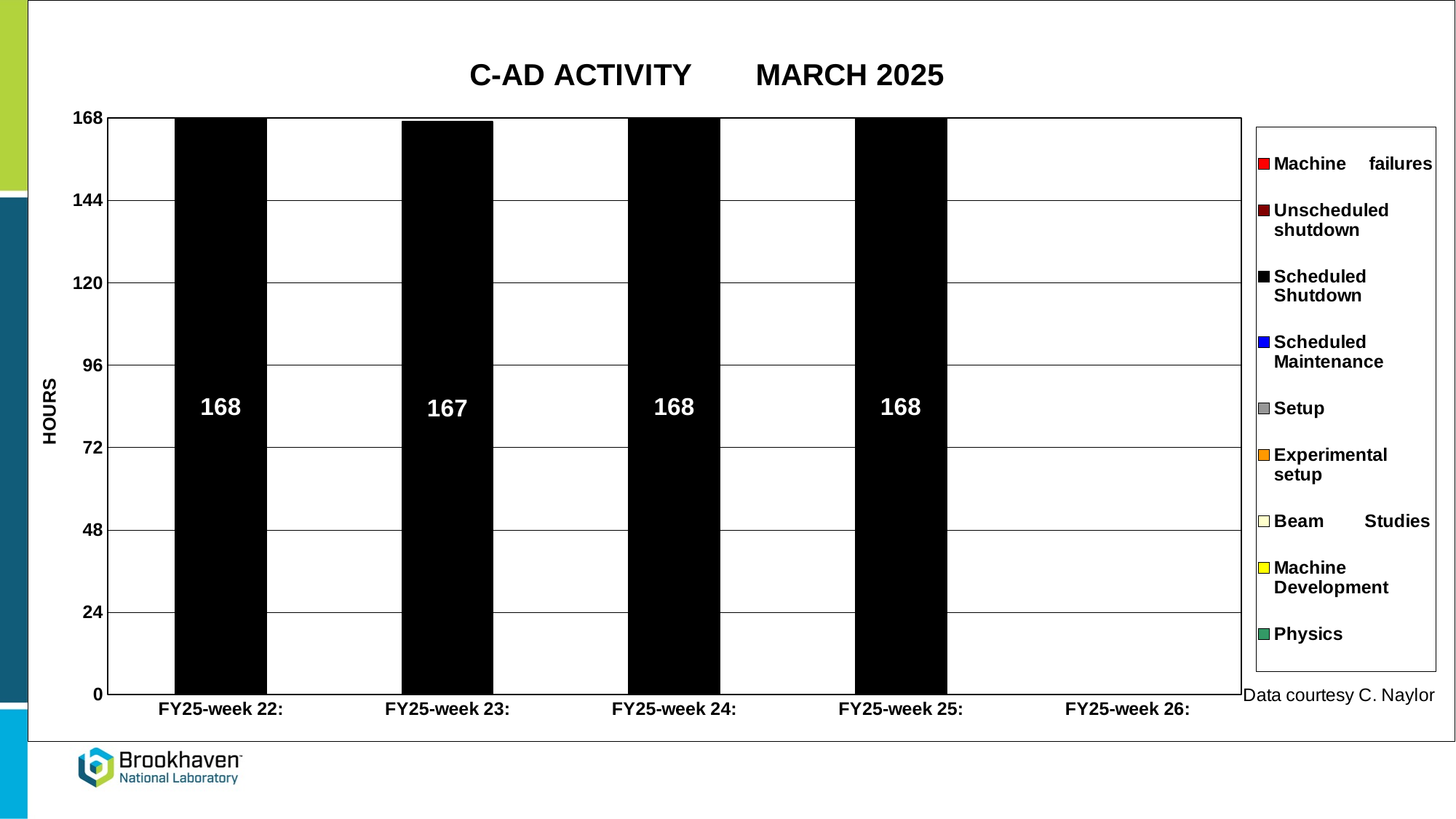
What is the value for FY25-week 22:? 168 How many series does the legend list? 9 Is the value for FY25-week 23: greater or less than 144? greater What is the value for FY25-week 25:? 168 What is the difference between the values for FY25-week 22: and FY25-week 23:? 1 What is the label of the y axis? HOURS How many categories are shown on the x axis? 5 What is the value for FY25-week 23:? 167 What kind of chart is shown on the slide? bar chart Which is larger, the value for FY25-week 24: or the value for FY25-week 23:? FY25-week 24: What colour represents Scheduled Shutdown in the legend? black Among the weeks that have a labelled bar, which has the lowest value? FY25-week 23: